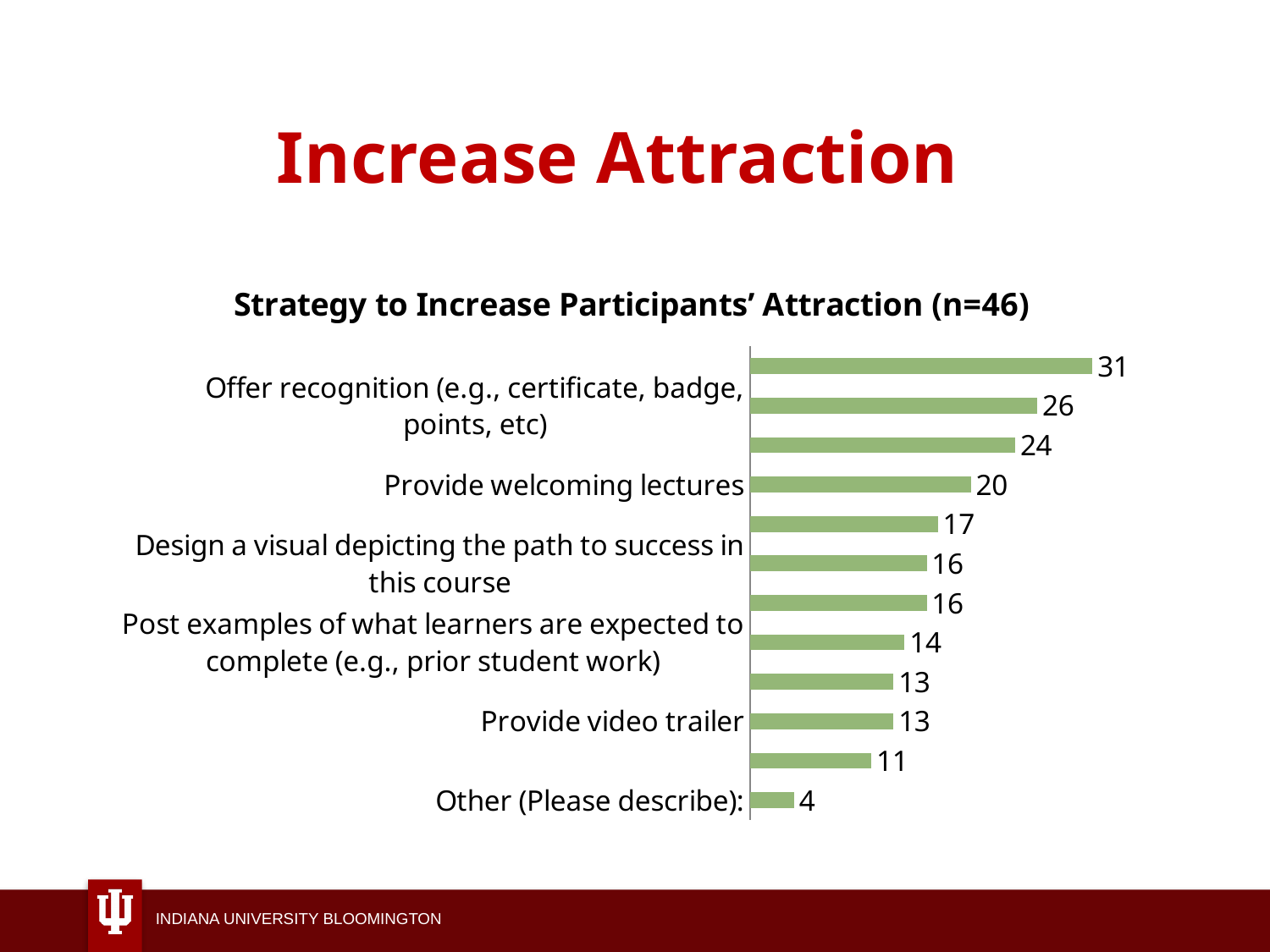
What is the value for "Provide video trailer"? 13 What is the value for "Other (Please describe):"? 4 What is the highest value shown in the chart? 31 What is the title of the chart? Strategy to Increase Participants' Attraction (n=46) Which category has the lowest value? Other (Please describe): What is the value for "Post examples of what learners are expected to complete (e.g., prior student work)"? 14 What is the value for "Provide welcoming lectures"? 20 What is the difference between the values for "Provide welcoming lectures" and "Provide video trailer"? 7 How many bars are plotted in the chart? 12 What is the sample size (n) given in the chart title? 46 What kind of chart is shown on the slide? bar chart Which is larger, the value for "Provide welcoming lectures" or the value for "Provide video trailer"? Provide welcoming lectures